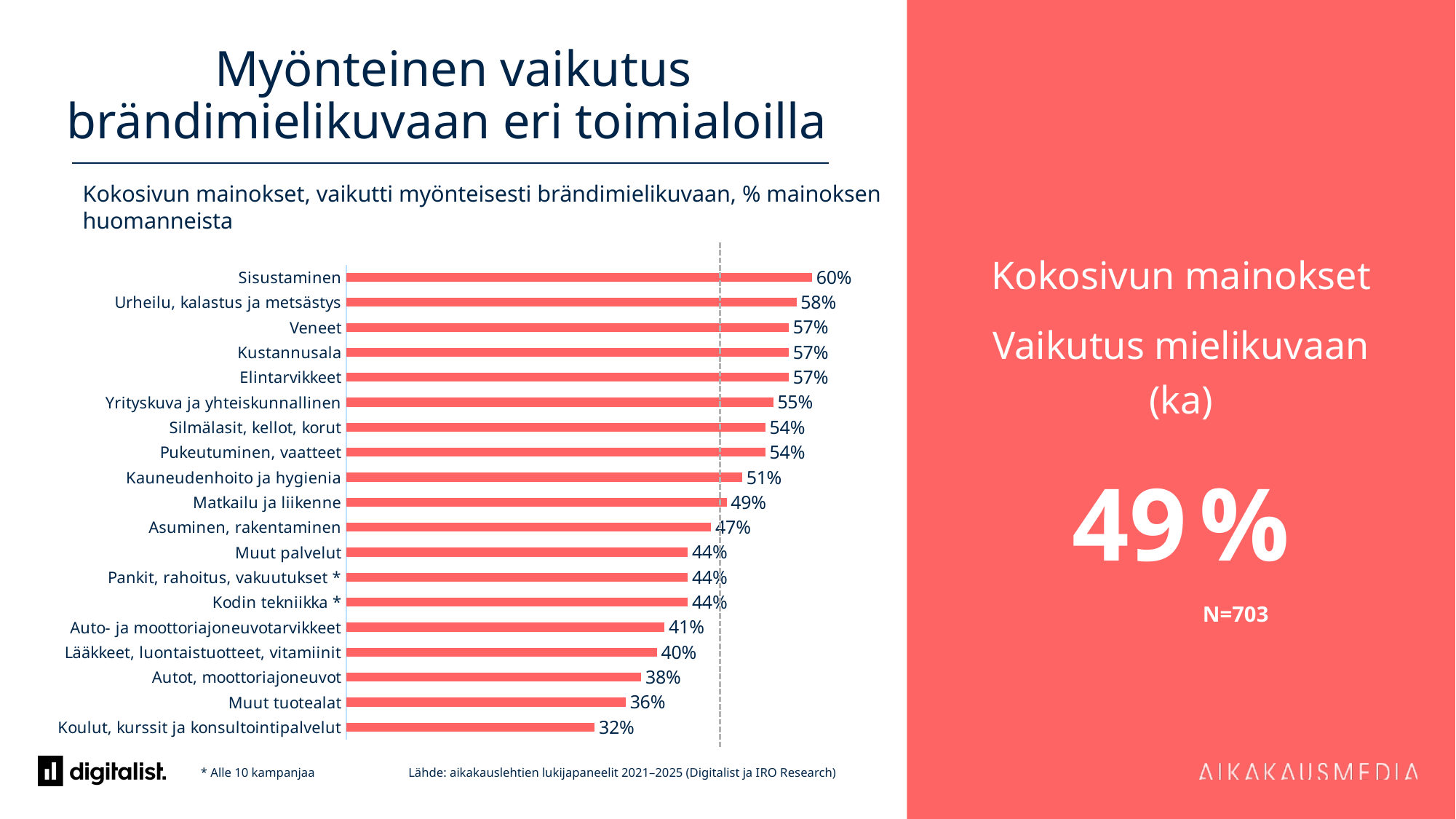
What average value (ka) is shown in the red panel on the right? 49 % What is the value for Sisustaminen? 60% What kind of chart is shown on the slide? Bar chart What is the value for Lääkkeet, luontaistuotteet, vitamiinit? 40% What is the difference between the values for Urheilu, kalastus ja metsästys and Autot, moottoriajoneuvot? 20 percentage points How many categories are shown in the chart? 19 What is the difference between the values for Sisustaminen and Koulut, kurssit ja konsultointipalvelut? 28 percentage points Which category has the lowest value? Koulut, kurssit ja konsultointipalvelut Which category has the highest value? Sisustaminen What is the value for Matkailu ja liikenne? 49% Which has a larger value, Kauneudenhoito ja hygienia or Muut tuotealat? Kauneudenhoito ja hygienia What is the value for Koulut, kurssit ja konsultointipalvelut? 32%